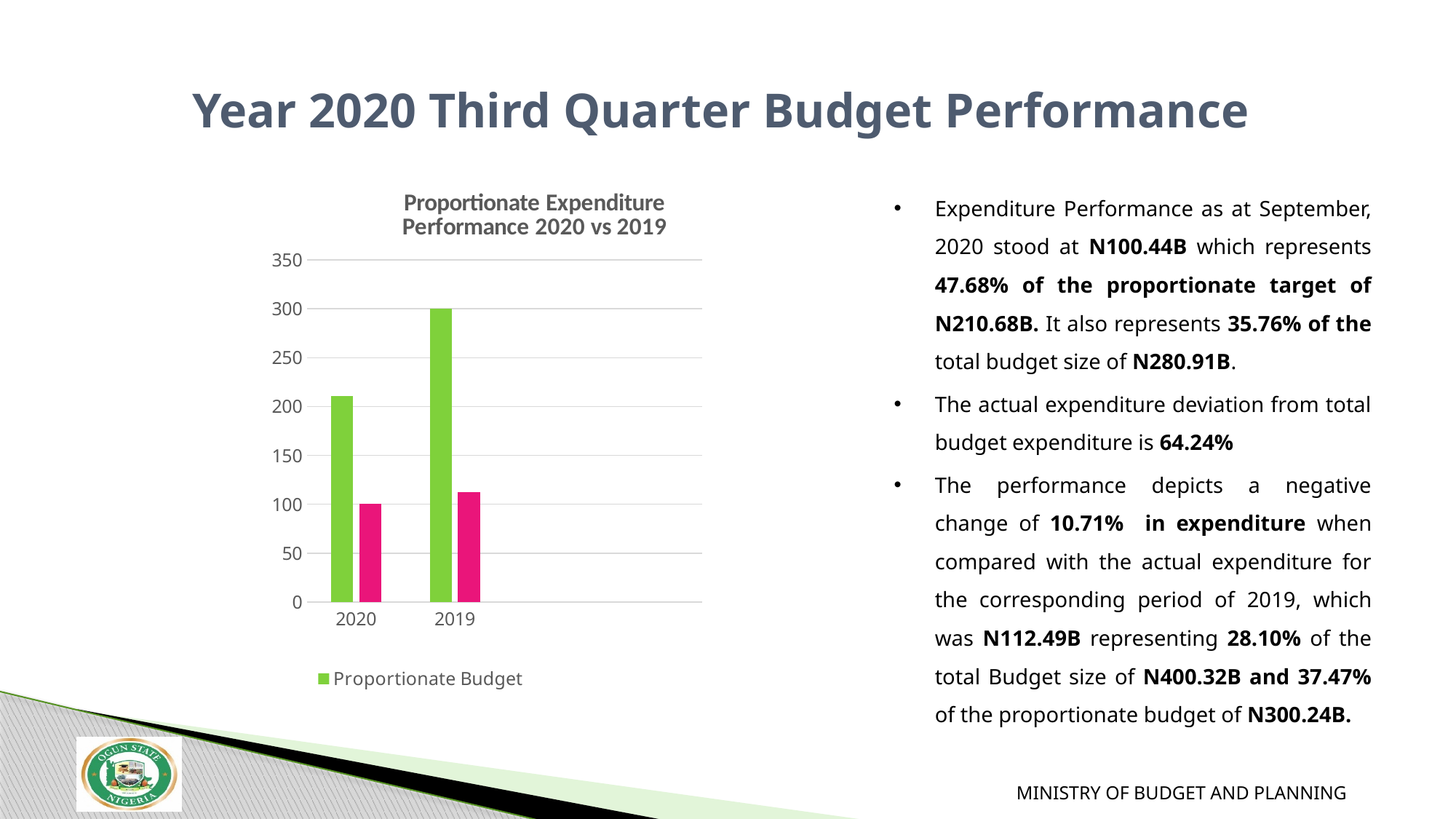
Which year has the taller Proportionate Budget (green) bar? 2019 What is the title of the chart? Proportionate Expenditure Performance 2020 vs 2019 Is the Proportionate Budget (green) bar for 2020 greater or less than 150? greater What kind of chart is shown on the slide? bar chart Is the pink bar for 2020 greater or less than 150? less Which year has the shorter Proportionate Budget (green) bar? 2020 Is the Proportionate Budget (green) bar larger for 2020 or for 2019? 2019 How many series does the chart's legend list? 1 Is the Proportionate Budget (green) bar for 2019 greater or less than 250? greater How many categories are shown on the x axis of the chart? 2 What series name does the legend show for the green bars? Proportionate Budget